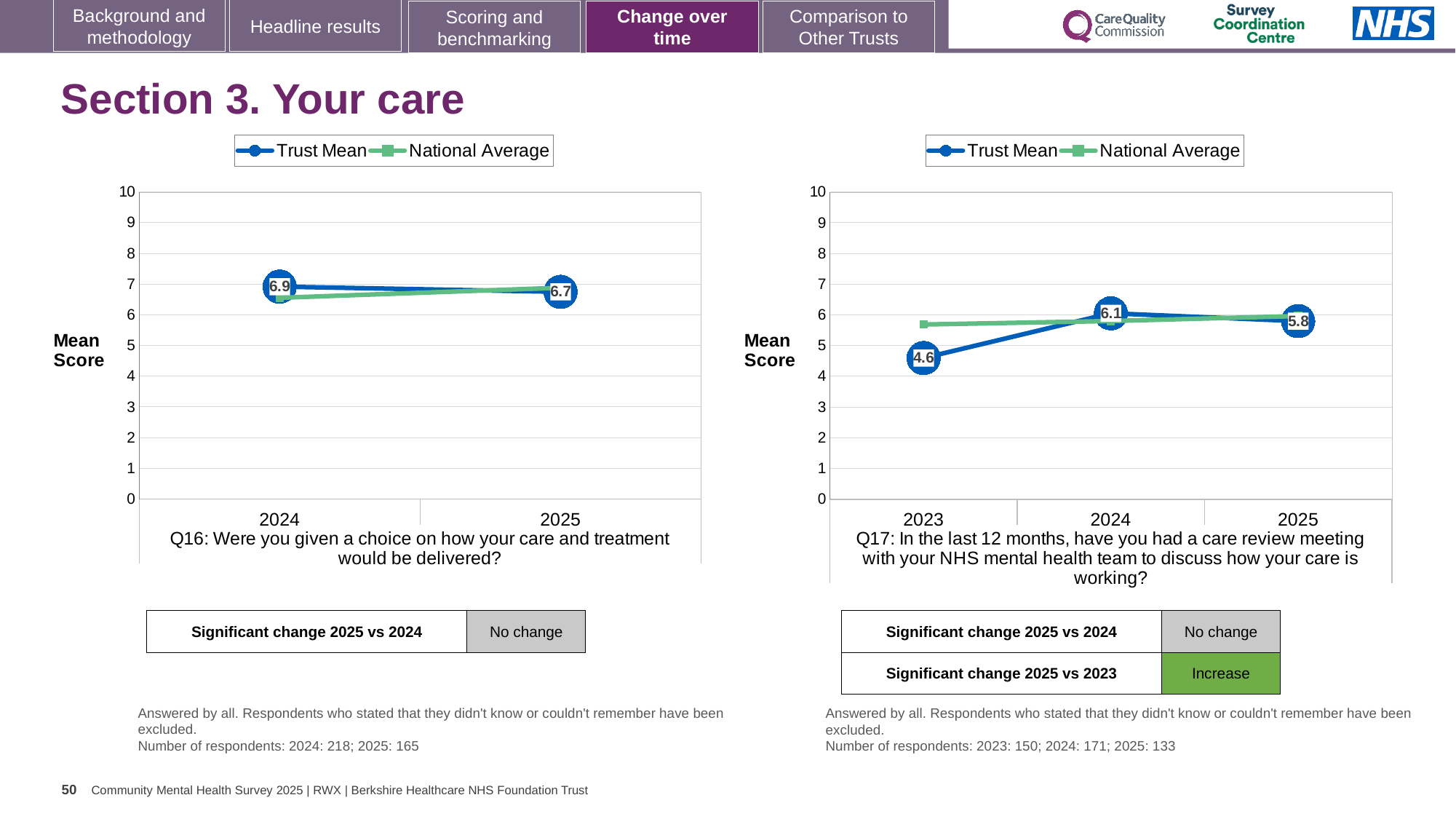
In the right chart (Q17), what is the Trust Mean for 2025? 5.8 In the left chart (Q16), what is the difference between the Trust Mean for 2024 and 2025? 0.2 In the right chart (Q17), which year has the highest Trust Mean? 2024 In the left chart (Q16), what is the Trust Mean for 2024? 6.9 In the right chart (Q17), what is the difference between the Trust Mean for 2024 and 2023? 1.5 What type of chart is the left chart (Q16)? Line chart In the right chart (Q17), is the National Average for 2023 greater or less than 5? greater How many years are plotted on the x axis of the right chart (Q17)? 3 In the right chart (Q17), which year has the lowest Trust Mean? 2023 In the right chart (Q17), what is the Trust Mean for 2023? 4.6 In the left chart (Q16), what is the Trust Mean for 2025? 6.7 In the left chart (Q16), is the Trust Mean for 2024 or 2025 larger? 2024